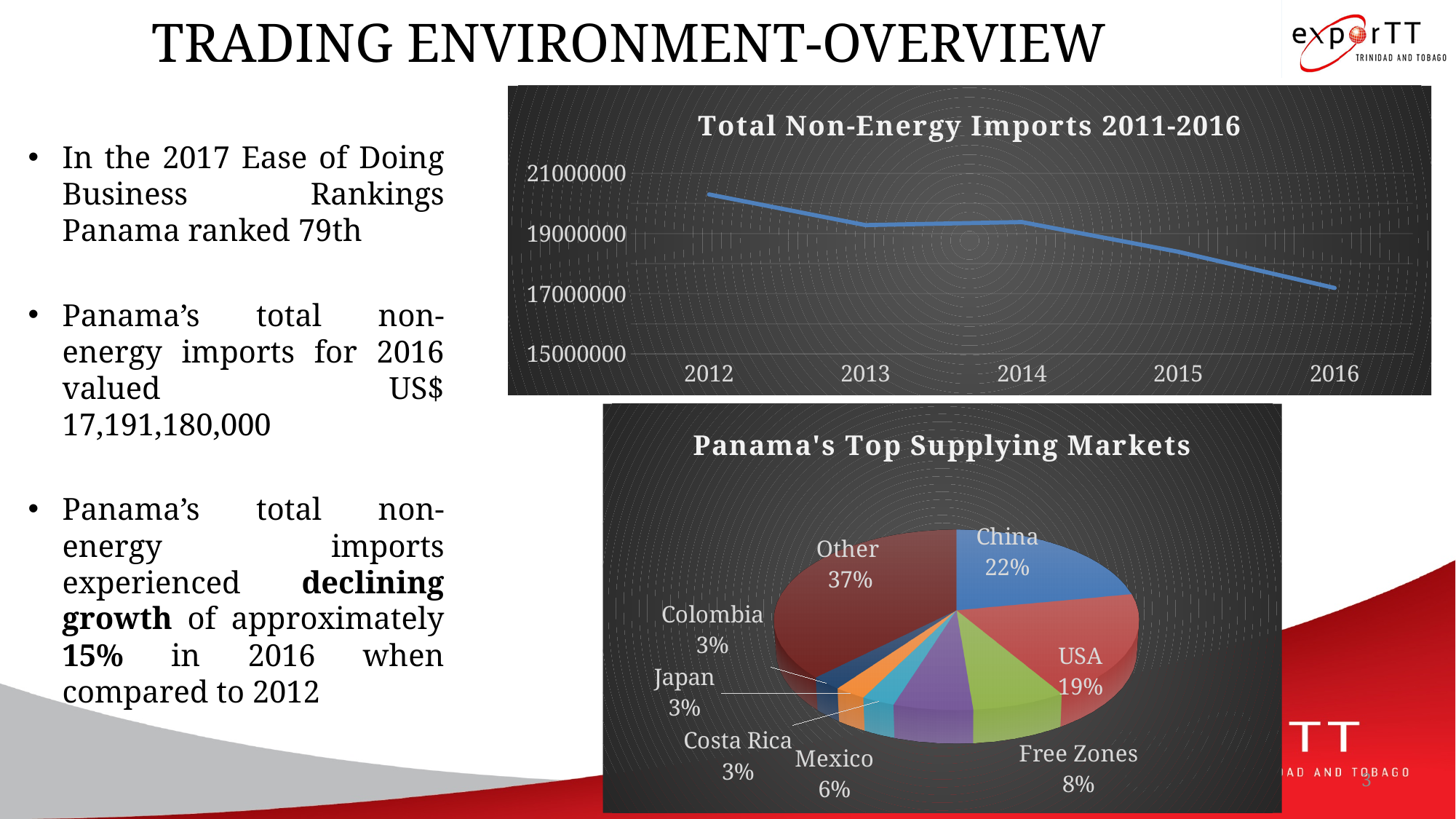
In the 'Total Non-Energy Imports 2011-2016' chart, is the value for 2012 greater or less than 19000000? greater What kind of chart is the 'Total Non-Energy Imports 2011-2016' chart? line chart In the 'Total Non-Energy Imports 2011-2016' chart, which year has the highest value? 2012 In the 'Panama's Top Supplying Markets' chart, what share does China have? 22% In the 'Panama's Top Supplying Markets' chart, how many percentage points larger is China's share than the USA's share? 3% How many years are plotted on the x axis of the 'Total Non-Energy Imports 2011-2016' chart? 5 What kind of chart is 'Panama's Top Supplying Markets'? pie chart In the 'Total Non-Energy Imports 2011-2016' chart, which year has the lowest value? 2016 In the 'Total Non-Energy Imports 2011-2016' chart, do the values rise or fall from 2012 to 2016? fall In the 'Panama's Top Supplying Markets' chart, which slice is the largest? Other How many slices does the 'Panama's Top Supplying Markets' pie chart have? 8 In the 'Total Non-Energy Imports 2011-2016' chart, is the value for 2015 greater or less than 19000000? less